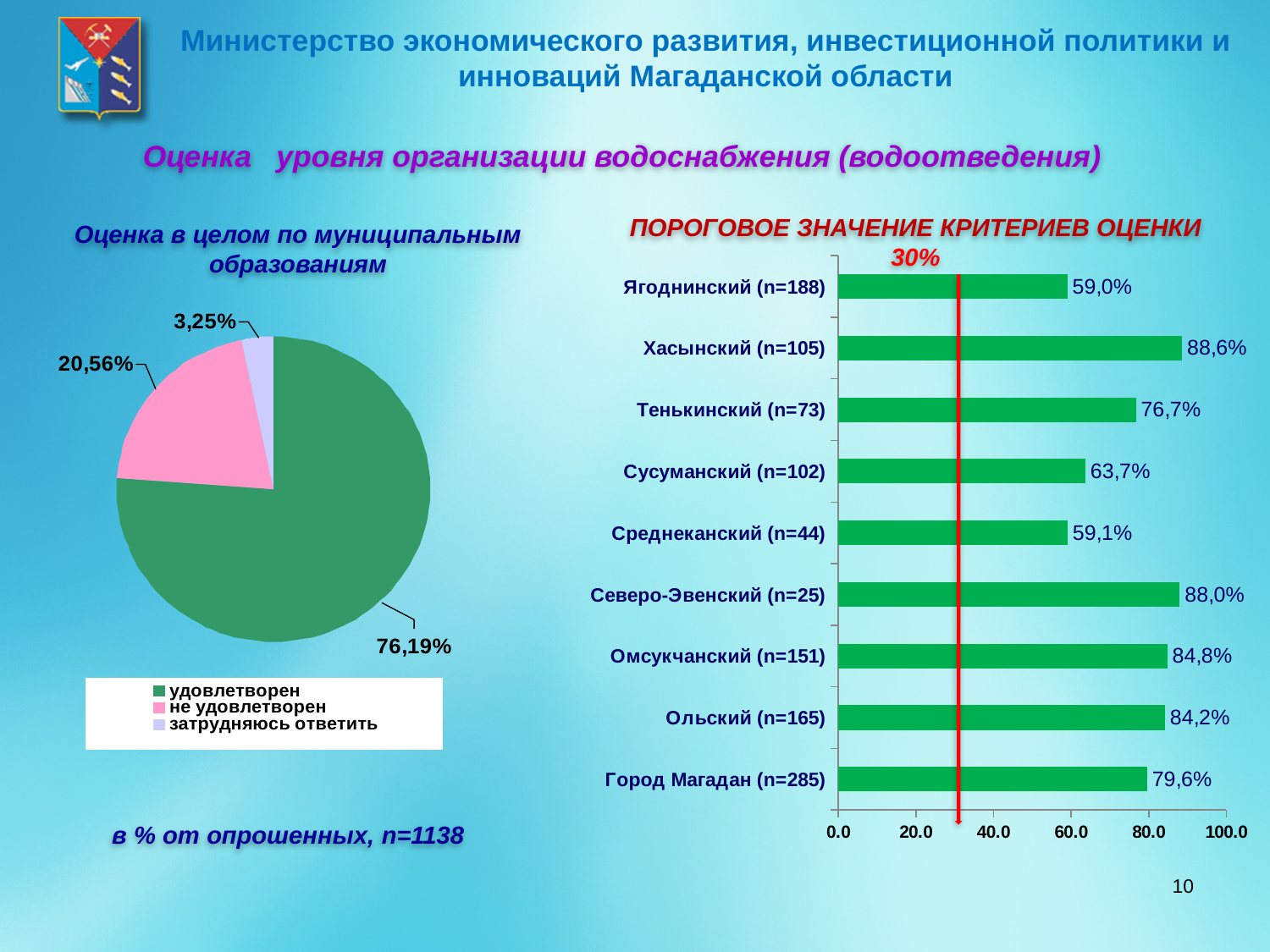
What type of chart is on the left side of the slide? pie chart In the pie chart on the left, what share is labelled for 'удовлетворен'? 76,19% In the bar chart on the right, how many municipalities are shown? 9 In the bar chart on the right, which is larger: the value for Тенькинский (n=73) or Сусуманский (n=102)? Тенькинский (n=73) What type of chart is on the right side of the slide? bar chart In the bar chart on the right, what is the difference between the values for Омсукчанский (n=151) and Ольский (n=165)? 0,6% In the bar chart on the right, what is the value for Хасынский (n=105)? 88,6% In the pie chart on the left, what share is labelled for 'не удовлетворен'? 20,56% In the pie chart on the left, what is the value of the smallest slice? 3,25% In the bar chart on the right, which municipality has the highest value? Хасынский (n=105) How many entries does the legend of the pie chart on the left list? 3 In the bar chart on the right, what is the value for Город Магадан (n=285)? 79,6%